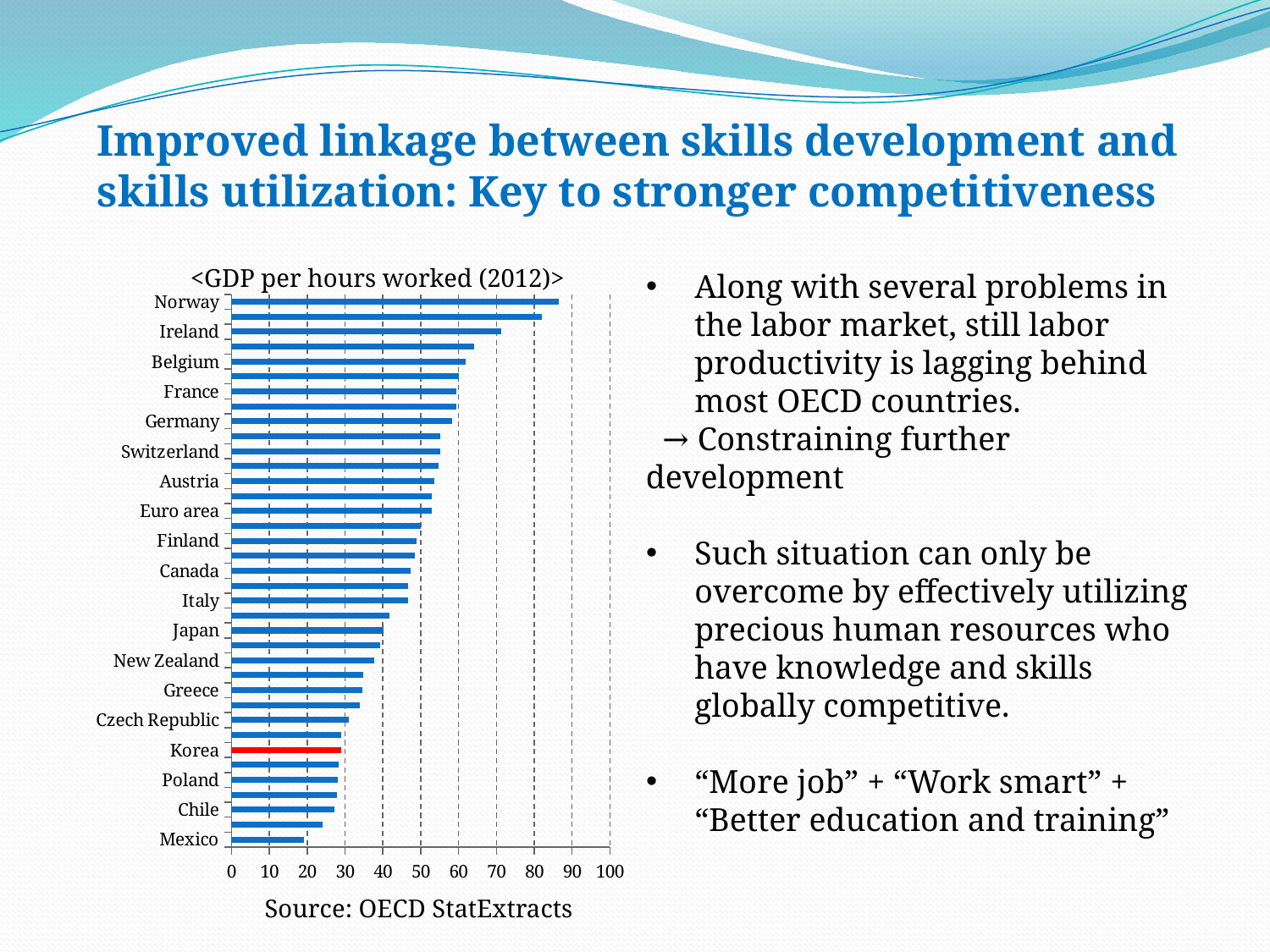
Which country's bar is highlighted in red in the chart? Korea Which has a higher GDP per hours worked, Japan or Ireland? Ireland Do the bar values increase or decrease going from the top of the chart (Norway) to the bottom (Mexico)? decrease Is the value for Ireland greater or less than 60? greater Is the value for Canada greater or less than 50? less What kind of chart is shown on the slide? bar chart Is the value for Korea greater or less than 40? less Which country has the lowest GDP per hours worked in the chart? Mexico Which country has the highest GDP per hours worked in the chart? Norway Which has a higher GDP per hours worked, Germany or Korea? Germany